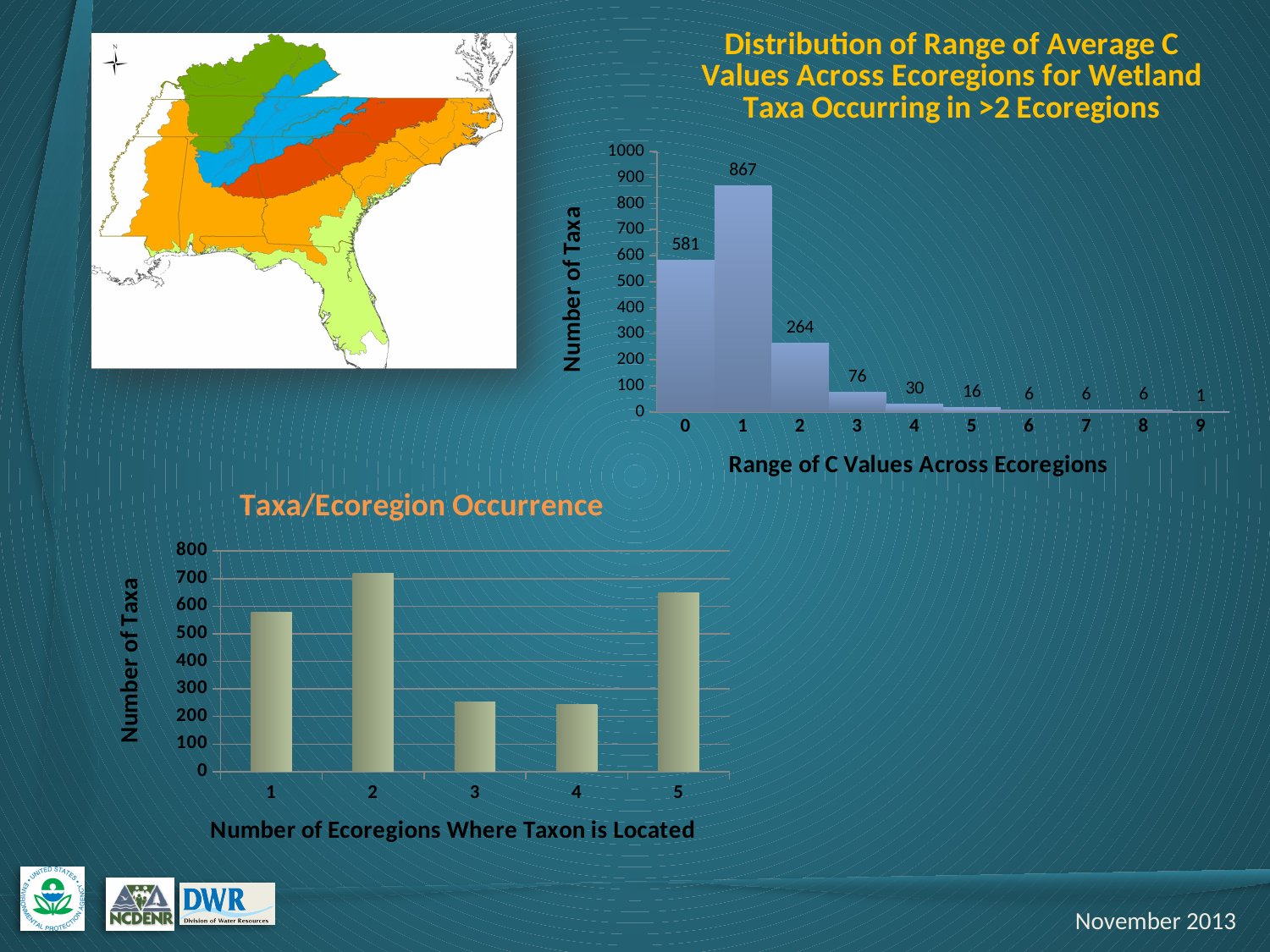
In the 'Taxa/Ecoregion Occurrence' chart, which number of ecoregions has the highest number of taxa? 2 In the 'Taxa/Ecoregion Occurrence' chart, which is larger, the value for 1 ecoregion or the value for 4 ecoregions? 1 ecoregion In the 'Distribution of Range of Average C Values' chart, which range value has the lowest number of taxa? 9 In the 'Distribution of Range of Average C Values' chart, what is the difference between the number of taxa for range 1 and range 0? 286 What kind of chart is the 'Taxa/Ecoregion Occurrence' chart? bar chart In the 'Distribution of Range of Average C Values' chart, what is the number of taxa for a range of 3? 76 In the 'Taxa/Ecoregion Occurrence' chart, is the value for 5 ecoregions greater or less than 600? greater In the 'Distribution of Range of Average C Values' chart, which range value has the highest number of taxa? 1 In the 'Distribution of Range of Average C Values' chart, how many range categories are shown on the x axis? 10 In the 'Distribution of Range of Average C Values' chart, what is the number of taxa for a range of 1? 867 In the 'Taxa/Ecoregion Occurrence' chart, is the value for 3 ecoregions greater or less than 300? less In the 'Distribution of Range of Average C Values' chart, do the values rise or fall from range 1 to range 9? fall